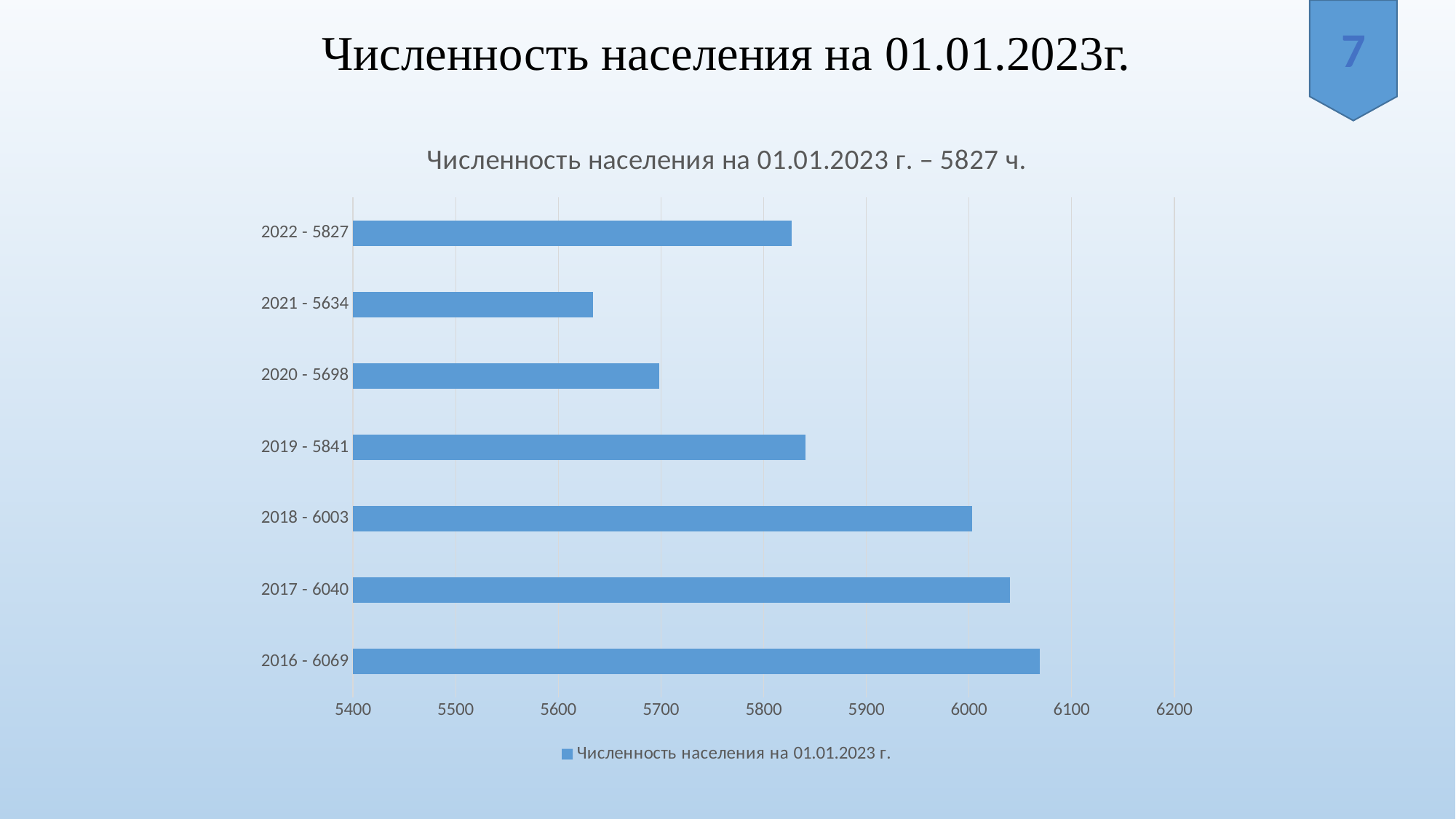
Which year has the larger population value, 2018 or 2019? 2018 What is the population value shown for 2022? 5827 How many years are shown in the chart? 7 What is the population value shown for 2018? 6003 What is the difference between the population values for 2019 and 2020? 143 What is the difference between the population values for 2016 and 2022? 242 What is the population value shown for 2020? 5698 Which year has the highest population value? 2016 Which year has the lowest population value? 2021 Do the population values rise or fall from 2016 to 2021? fall What kind of chart is shown on the slide? bar chart Is the value for 2021 greater or less than 5700? less